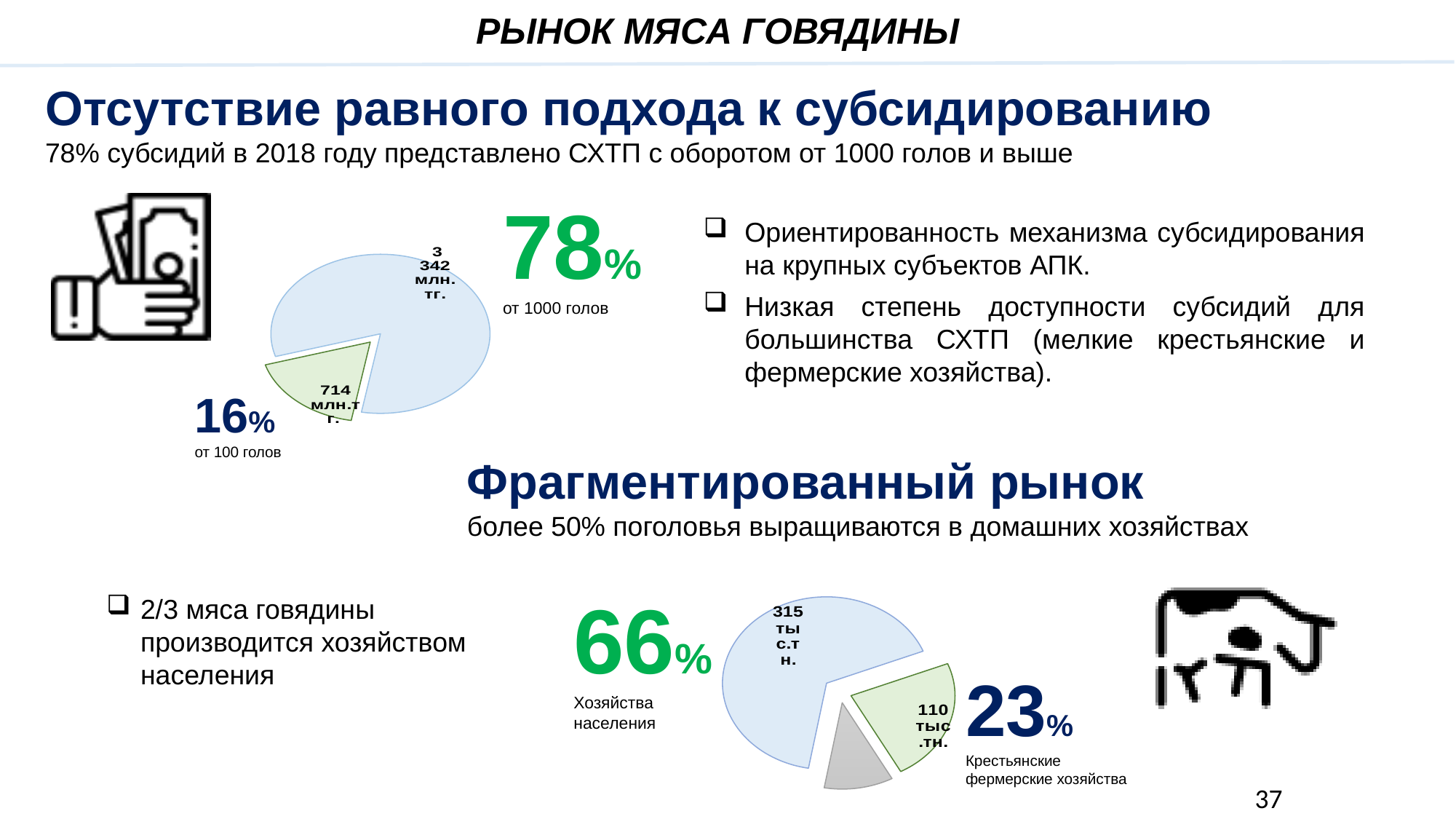
What kind of chart is the upper chart about subsidies (next to 78% and 16%)? pie chart In the upper subsidies pie chart, what is the difference between the 'от 1000 голов' value and the 'от 100 голов' value? 2 628 млн. тг. In the lower pie chart, what share is attributed to 'Крестьянские фермерские хозяйства'? 23% In the lower pie chart, what value is shown for 'Хозяйства населения'? 315 тыс.тн. In the upper subsidies pie chart, what value is shown for the slice labelled 'от 100 голов'? 714 млн.тг. What kind of chart is the lower chart about the fragmented market (next to 66% and 23%)? pie chart In the upper subsidies pie chart, what share of subsidies goes to producers 'от 1000 голов'? 78% In the upper subsidies pie chart, what value is shown for the slice labelled 'от 1000 голов'? 3 342 млн. тг. In the upper subsidies pie chart, what share of subsidies goes to producers 'от 100 голов'? 16% In the lower pie chart, what value is shown for 'Крестьянские фермерские хозяйства'? 110 тыс.тн. How many slices does the lower pie chart have? 3 In the upper subsidies pie chart, which slice is larger: 'от 1000 голов' or 'от 100 голов'? от 1000 голов